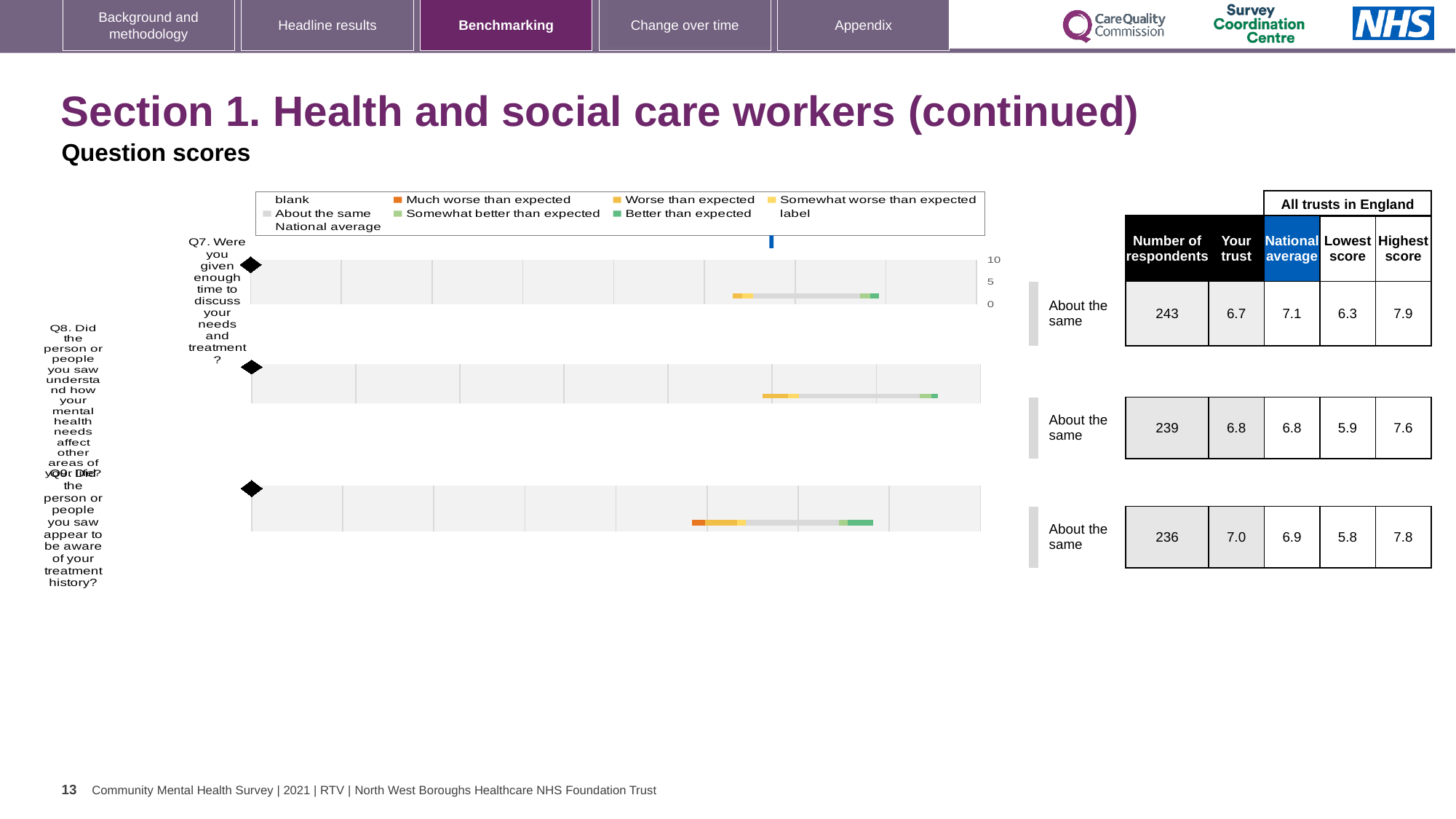
For Q7, which is larger: the 'Your trust' score or the national average? National average How many respondents are shown for Q7 (Were you given enough time to discuss your needs and treatment?)? 243 What is the lowest score among all trusts in England for Q8? 5.9 Is the 'Your trust' score for Q9 greater or less than 5? greater Which question has the highest 'Your trust' score? Q9 For Q7, what is the difference between the highest score and the lowest score across all trusts in England? 1.6 What is the 'Your trust' score for Q8 (Did the person or people you saw understand how your mental health needs affect other areas of your life?)? 6.8 How many questions are plotted on the slide? 3 What is the national average score for Q9 (Did the person or people you saw appear to be aware of your treatment history?)? 6.9 What benchmark category is shown for Q8? About the same Which question has the lowest 'Lowest score' across all trusts in England? Q9 For Q9, what is the difference between the highest score and the lowest score across all trusts in England? 2.0